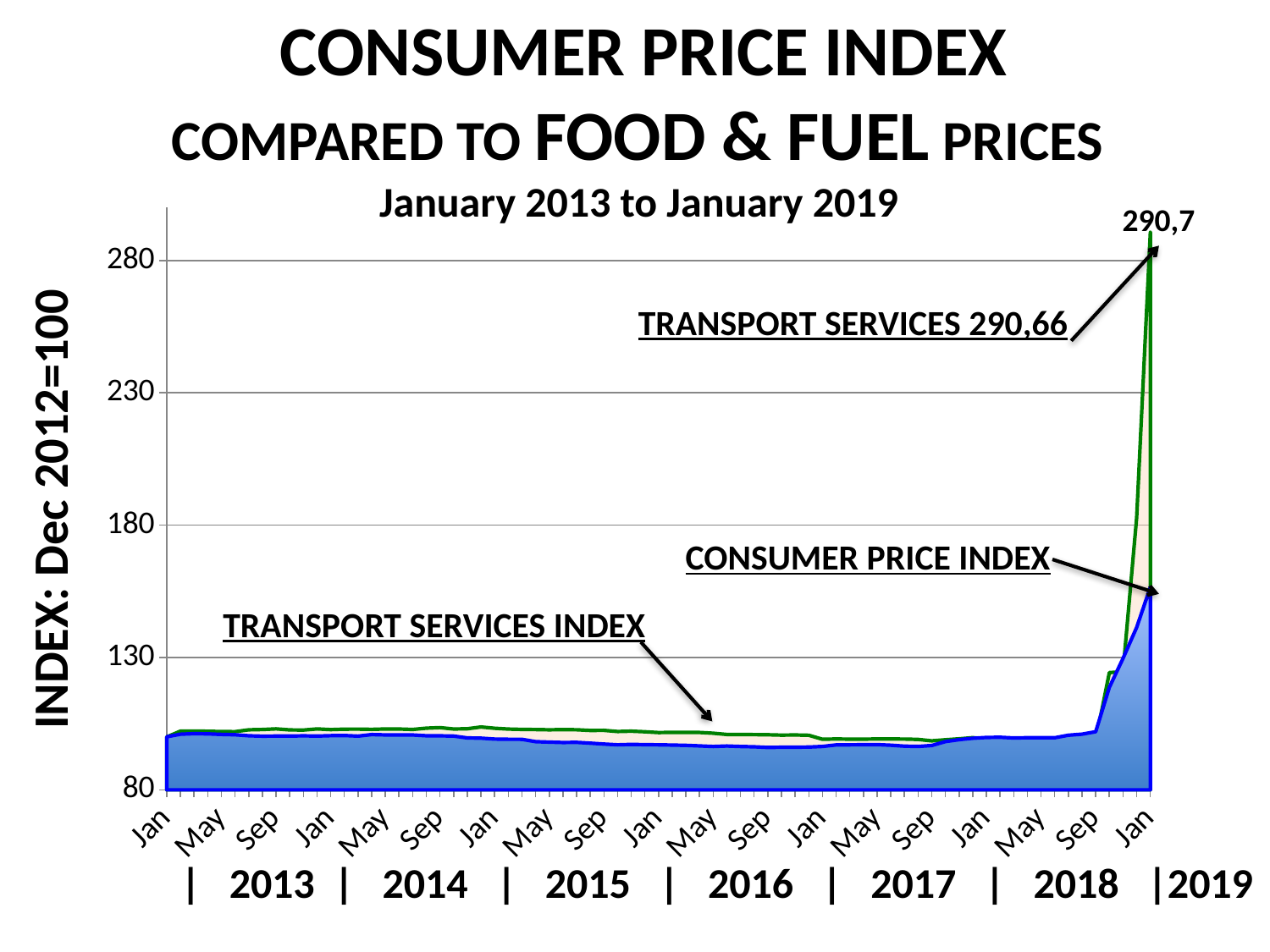
Is the Transport Services Index in January 2016 greater or less than 130? less In January 2019, which is higher, the Transport Services Index or the Consumer Price Index? Transport Services Index Is the Consumer Price Index in January 2019 greater or less than 130? greater Which series reaches the highest value on the chart? Transport Services Index What kind of chart is shown on the slide? area chart How many data series are plotted on the chart? 2 Does the Transport Services Index rise or fall between September 2018 and January 2019? rise Is the Transport Services Index in January 2019 greater or less than 280? greater What is the label on the vertical axis of the chart? INDEX: Dec 2012=100 What value does the data label show for the Transport Services Index in January 2019? 290,7